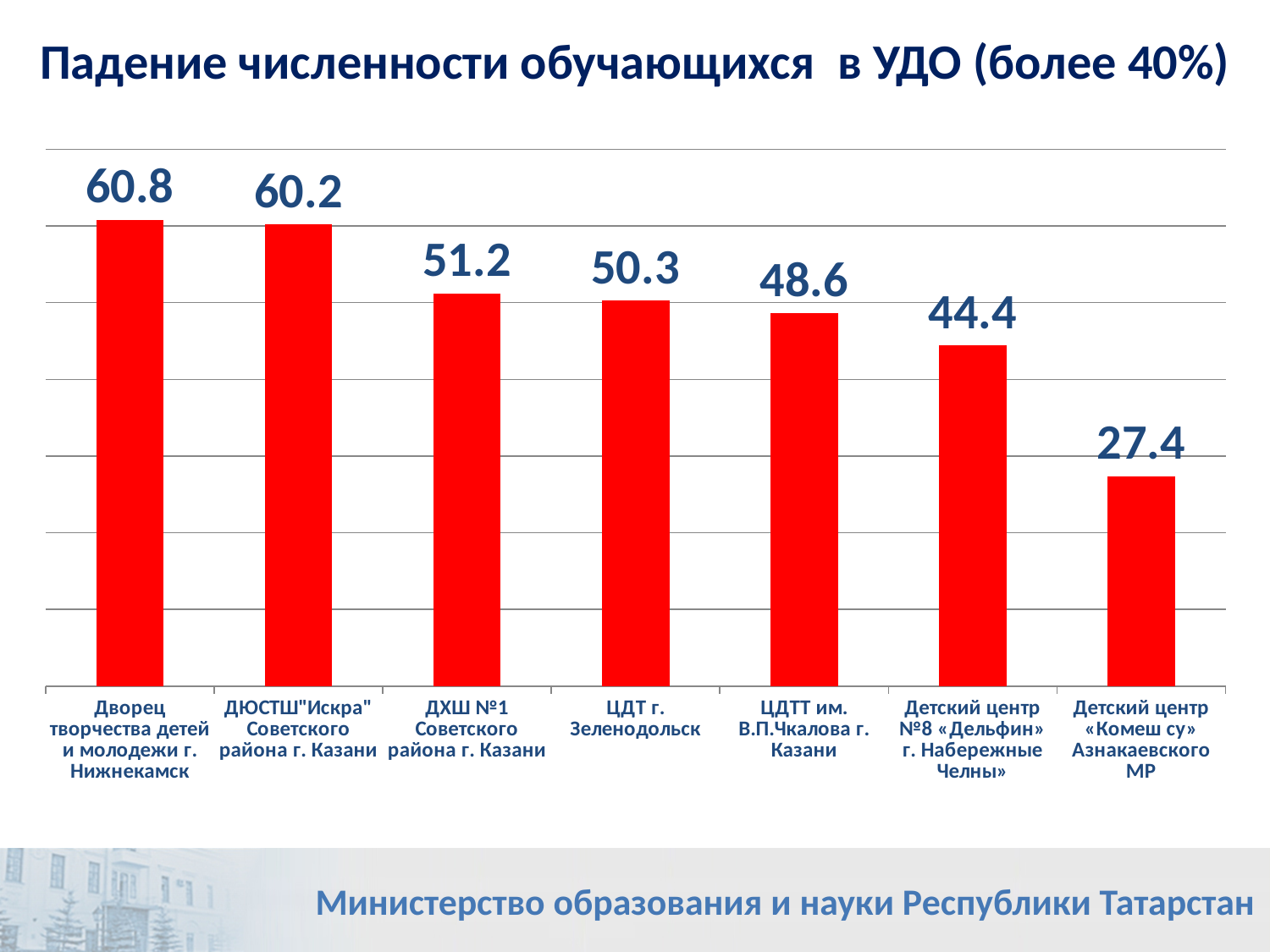
What is the value for ДЮСТШ "Искра" Советского района г. Казани? 60.2 What is the difference between the values for ДХШ №1 Советского района г. Казани and ЦДТТ им. В.П.Чкалова г. Казани? 2.6 What is the title of the chart? Падение численности обучающихся в УДО (более 40%) Which category has the highest value? Дворец творчества детей и молодежи г. Нижнекамск What is the value for ЦДТ г. Зеленодольск? 50.3 Which category has the lowest value? Детский центр «Комеш су» Азнакаевского МР Which is larger: the value for ЦДТ г. Зеленодольск or the value for Детский центр №8 «Дельфин» г. Набережные Челны? ЦДТ г. Зеленодольск What is the difference between the highest and lowest values on the chart? 33.4 What kind of chart is shown on the slide? Bar chart Do the values rise or fall from left to right along the x axis? Fall What is the value for Детский центр «Комеш су» Азнакаевского МР? 27.4 How many categories are shown on the chart? 7